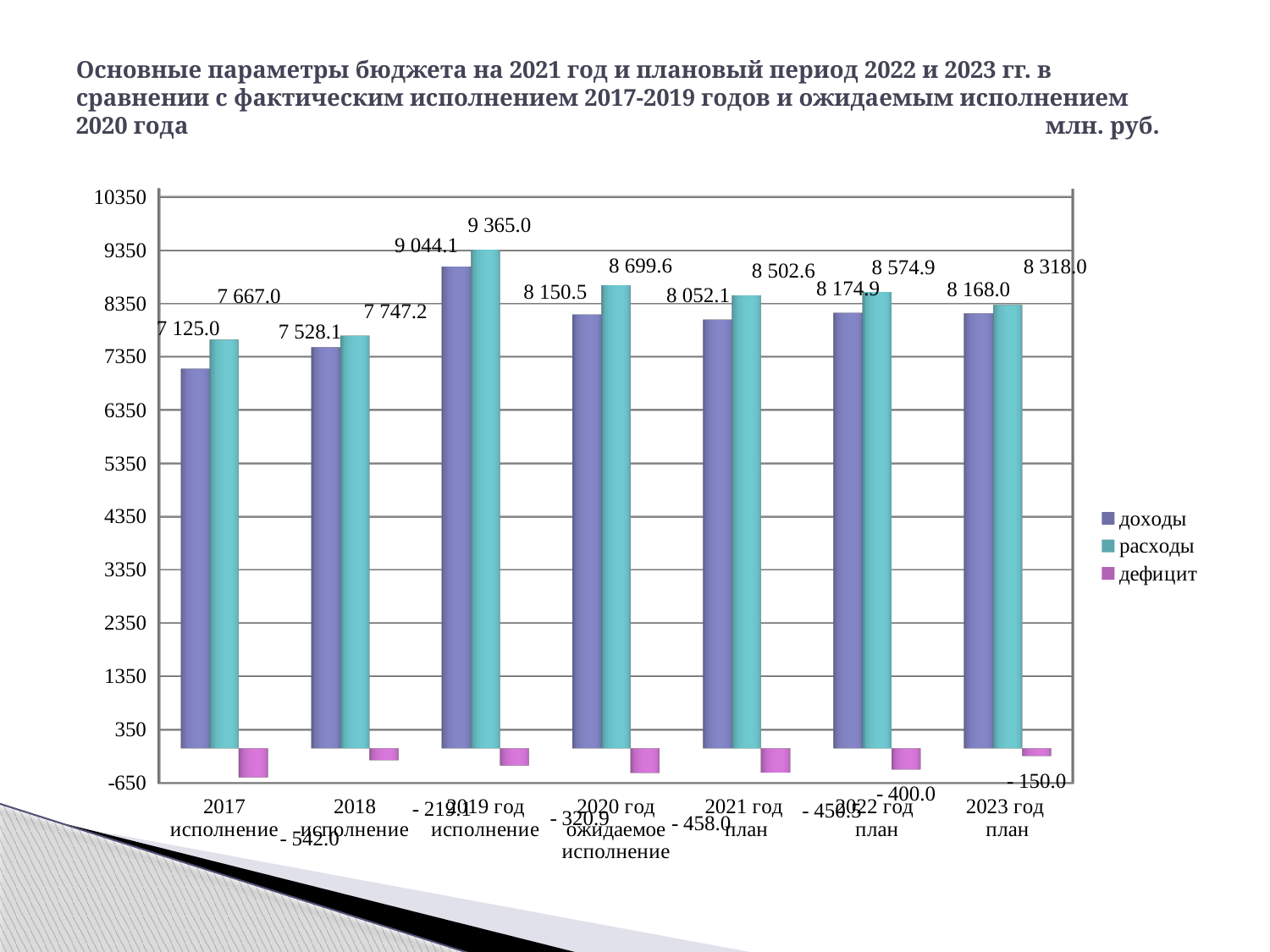
Is the value of доходы for 2017 исполнение greater or less than 7350? less In which year is расходы the highest? 2019 год исполнение What is the value of расходы for 2021 год план? 8 502.6 What are the three series listed in the legend? доходы, расходы, дефицит What is the difference between расходы and доходы for 2019 год исполнение? 320.9 In which year is доходы the lowest? 2017 исполнение How many year categories are shown on the x axis? 7 How many series does the legend list? 3 Which is larger: доходы for 2020 год ожидаемое исполнение or доходы for 2022 год план? 2022 год план What is the value of расходы for 2017 исполнение? 7 667.0 What kind of chart is shown on the slide? bar chart What is the value of доходы for 2019 год исполнение? 9 044.1